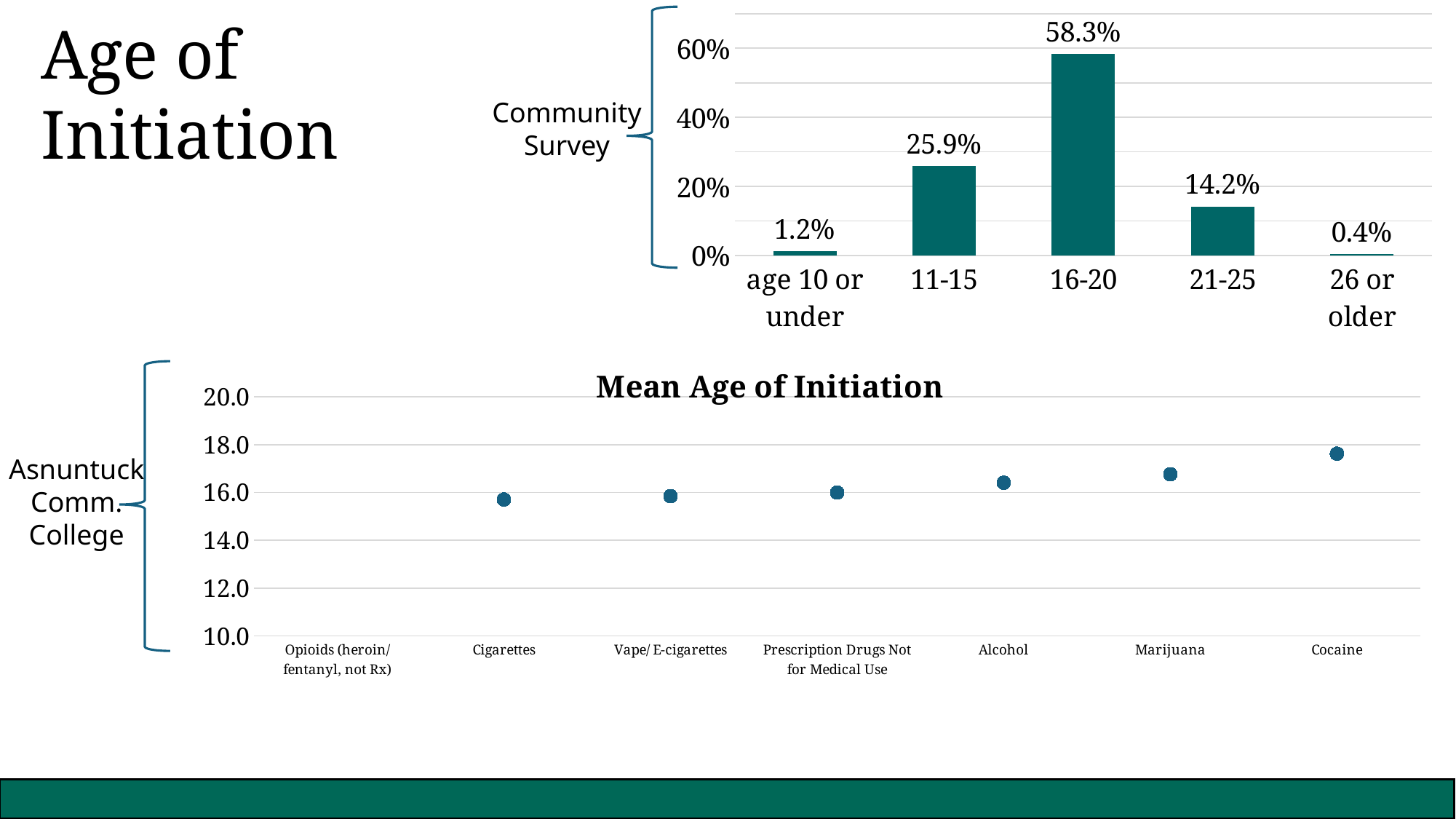
How many substance categories are listed on the x axis of the Mean Age of Initiation chart? 7 What type of chart is the Community Survey chart at the top of the slide? bar chart In the Mean Age of Initiation chart, is the value for Cocaine greater or less than 16.0? greater In the Community Survey bar chart, what percentage is shown for the 11-15 age group? 25.9% In the Mean Age of Initiation chart, which substance has the highest mean age of initiation? Cocaine In the Community Survey bar chart, which age group has the lowest percentage? 26 or older In the Community Survey bar chart, which is larger, the value for 11-15 or the value for 21-25? 11-15 How many age groups are shown in the Community Survey bar chart? 5 In the Community Survey bar chart, what percentage is shown for age 10 or under? 1.2% In the Community Survey bar chart, what percentage is shown for the 16-20 age group? 58.3% In the Community Survey bar chart, what is the difference between the 16-20 and 21-25 percentages? 44.1% In the Community Survey bar chart, which age group has the highest percentage? 16-20